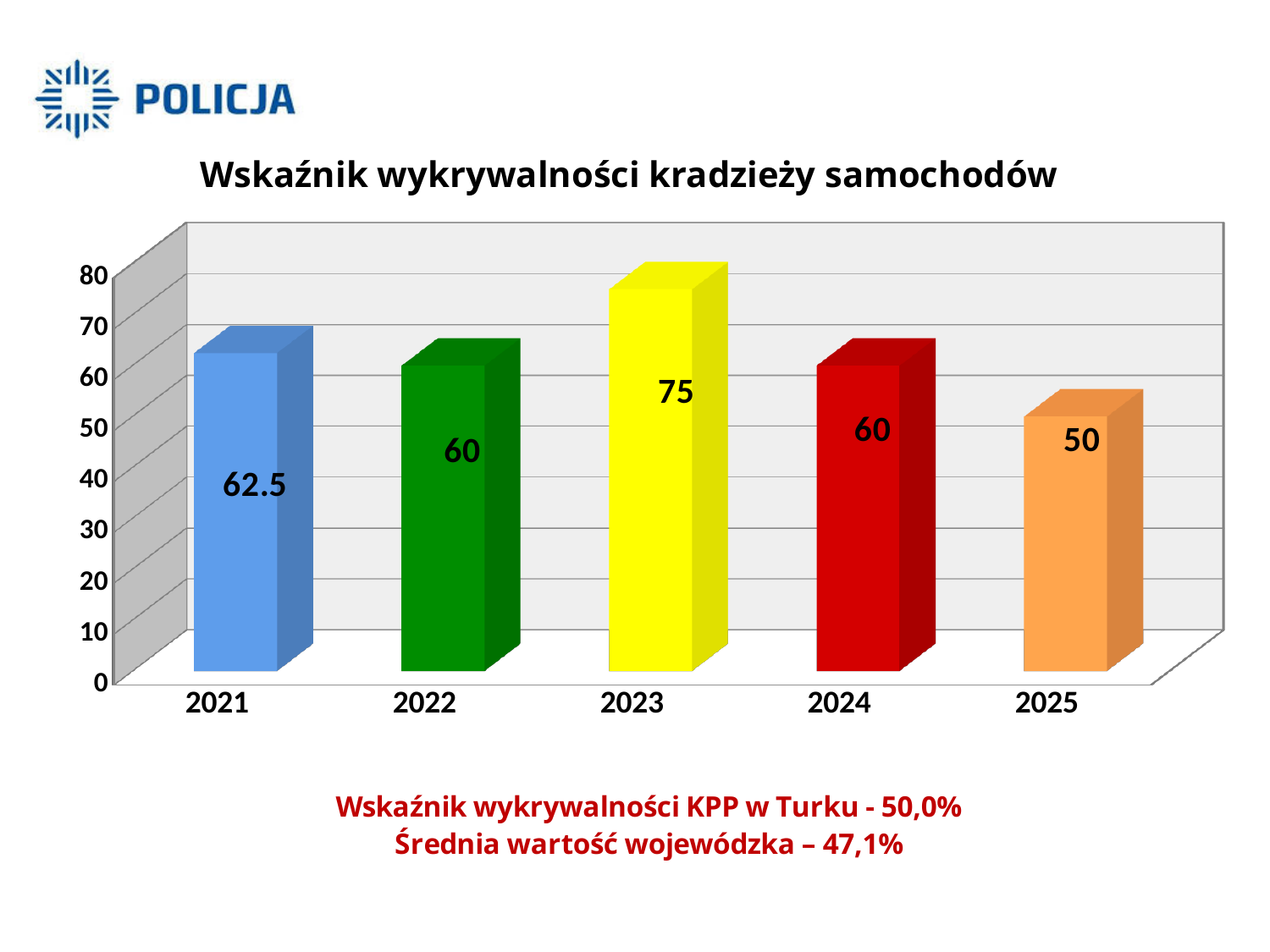
What is the difference between the values for 2021 and 2022? 2.5 What is the value for 2023? 75 Which year has the highest value? 2023 Which is larger, the value for 2021 or the value for 2024? 2021 How many years are shown on the x axis? 5 Which year has the lowest value? 2025 Do the values rise or fall from 2023 to 2025? fall What is the difference between the values for 2023 and 2025? 25 What is the value for 2021? 62.5 What is the value for 2025? 50 What kind of chart is this? bar chart What is the title of the chart? Wskaźnik wykrywalności kradzieży samochodów